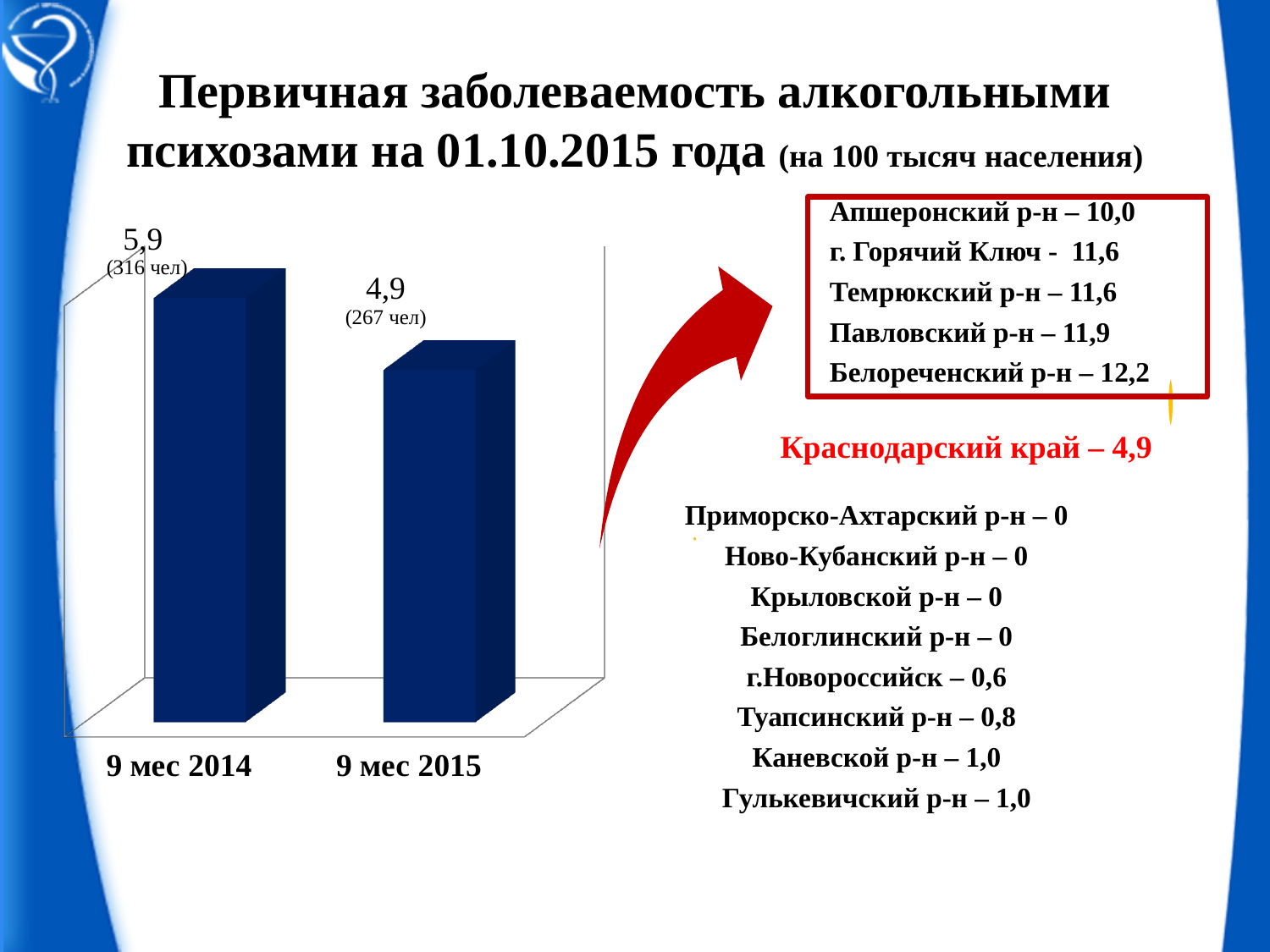
Which category has the highest value? 9 мес 2014 How many people (чел) are indicated under the 9 мес 2014 bar? 316 чел Which is larger, the value for 9 мес 2014 or for 9 мес 2015? 9 мес 2014 How many people (чел) are indicated under the 9 мес 2015 bar? 267 чел What is the difference between the values for 9 мес 2014 and 9 мес 2015? 1,0 Do the values rise or fall from 9 мес 2014 to 9 мес 2015? fall What is the value shown for 9 мес 2015? 4,9 What is the difference in the number of people between 9 мес 2014 (316 чел) and 9 мес 2015 (267 чел)? 49 What is the value shown for 9 мес 2014? 5,9 What kind of chart is shown on the slide? bar chart Which category has the lowest value? 9 мес 2015 How many bars are plotted in the chart? 2